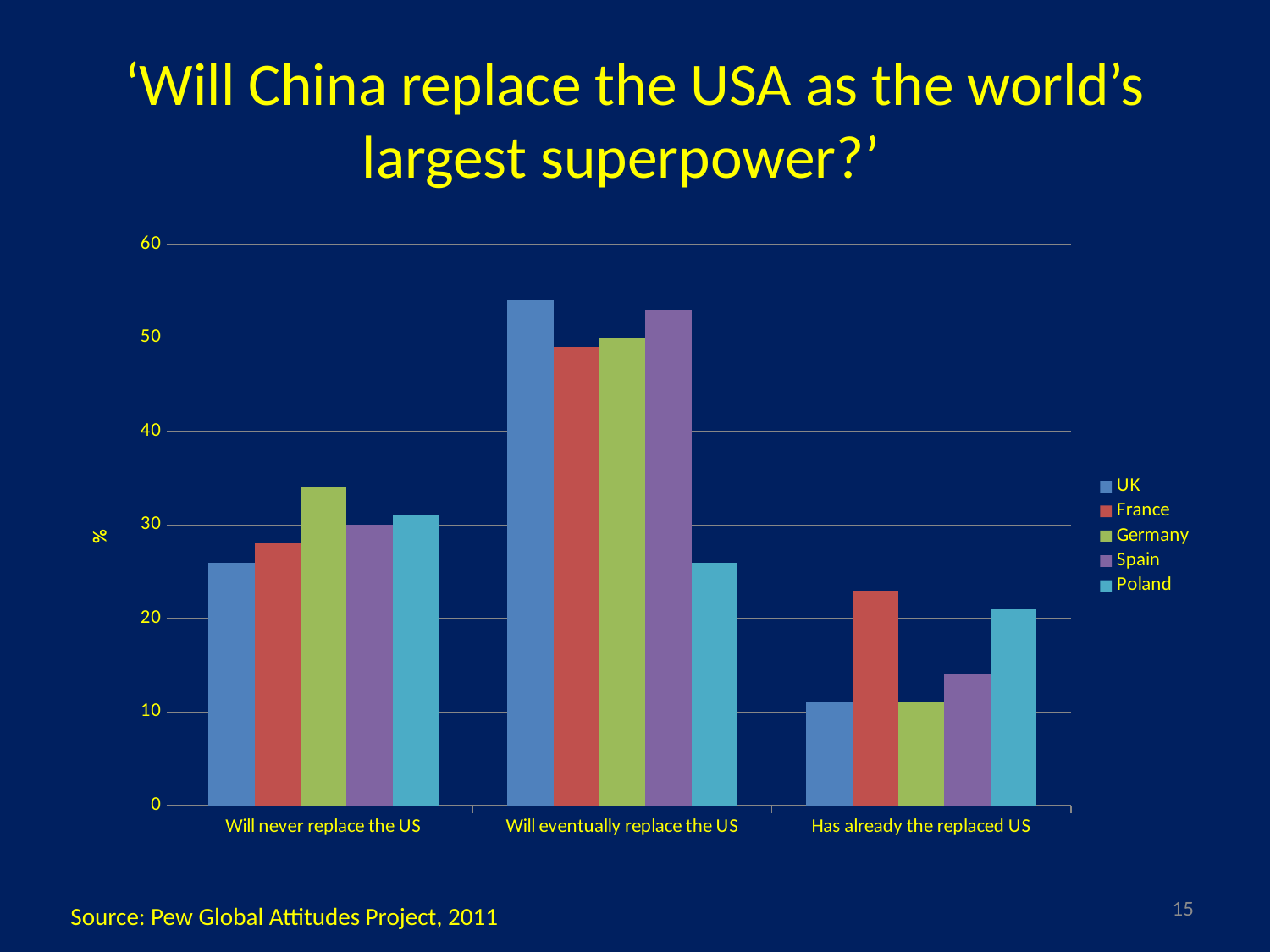
How many series does the legend list? 5 Is the value for Poland under 'Will eventually replace the US' greater or less than 30? less Which country is shown in red in the legend? France For the UK, which is larger: the bar for 'Will never replace the US' or the bar for 'Will eventually replace the US'? Will eventually replace the US What kind of chart is shown on the slide? bar chart Is the value for Germany under 'Will never replace the US' greater or less than 30? greater Is the value for UK under 'Will eventually replace the US' greater or less than 50? greater Which country has the lowest bar for 'Will eventually replace the US'? Poland How many categories are shown on the x axis? 3 Which country has the highest bar for 'Will never replace the US'? Germany What is the title of the chart? 'Will China replace the USA as the world's largest superpower?'